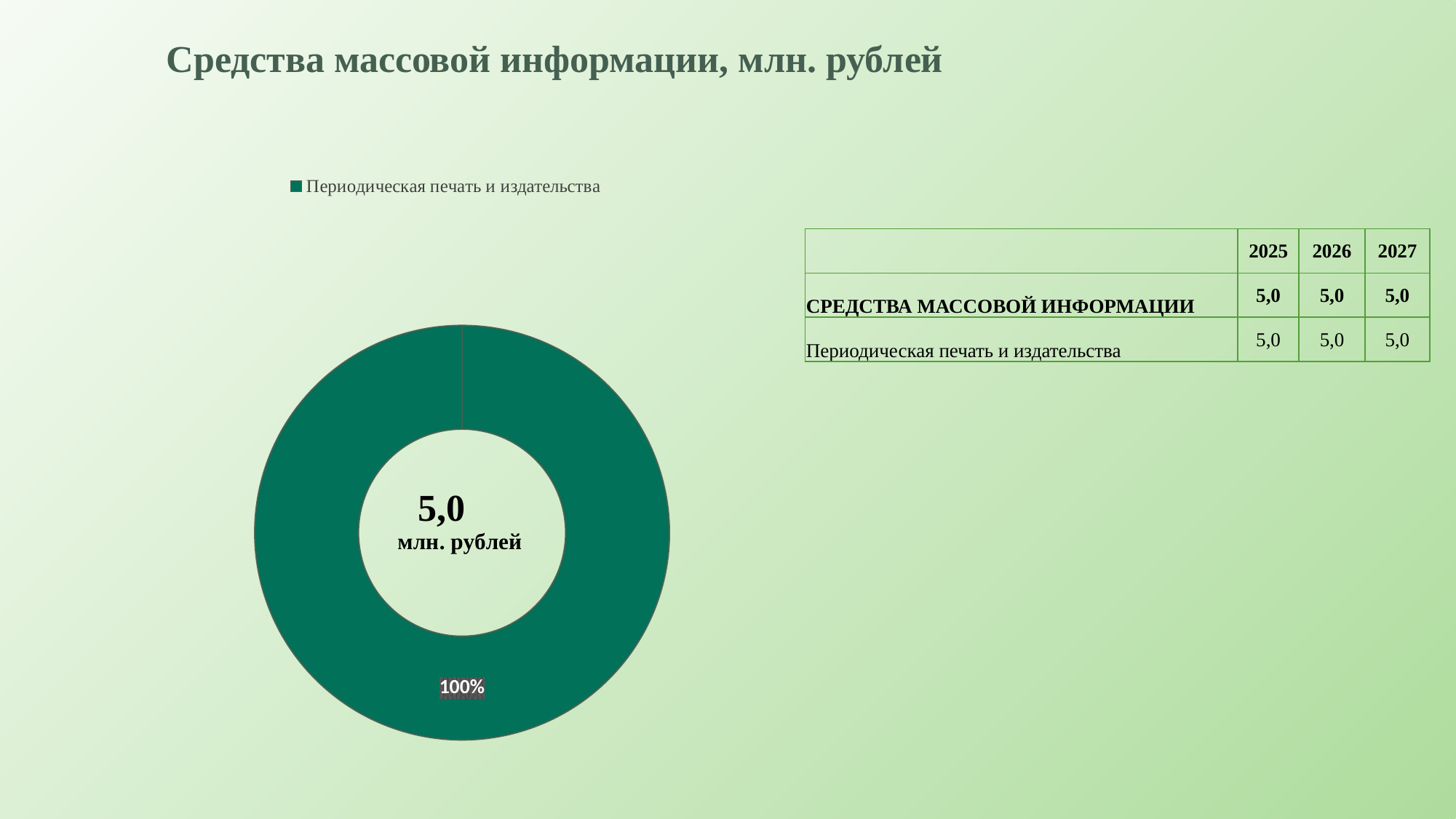
What share of the doughnut chart does the slice for Периодическая печать и издательства represent? 100% What is the difference between the 2025 and 2027 values for СРЕДСТВА МАССОВОЙ ИНФОРМАЦИИ in the table? 0,0 What is the title of the slide containing the doughnut chart? Средства массовой информации, млн. рублей According to the table, do the values for Периодическая печать и издательства rise, fall or stay the same from 2025 to 2027? Stay the same What total value is printed in the centre of the doughnut chart? 5,0 млн. рублей How many slices does the doughnut chart have? 1 What is the name of the only category shown in the legend of the doughnut chart? Периодическая печать и издательства According to the table, what is the value for СРЕДСТВА МАССОВОЙ ИНФОРМАЦИИ in 2027? 5,0 According to the table, what is the value for Периодическая печать и издательства in 2026? 5,0 How many entries does the legend of the doughnut chart list? 1 What kind of chart is shown on the slide? Doughnut (pie) chart